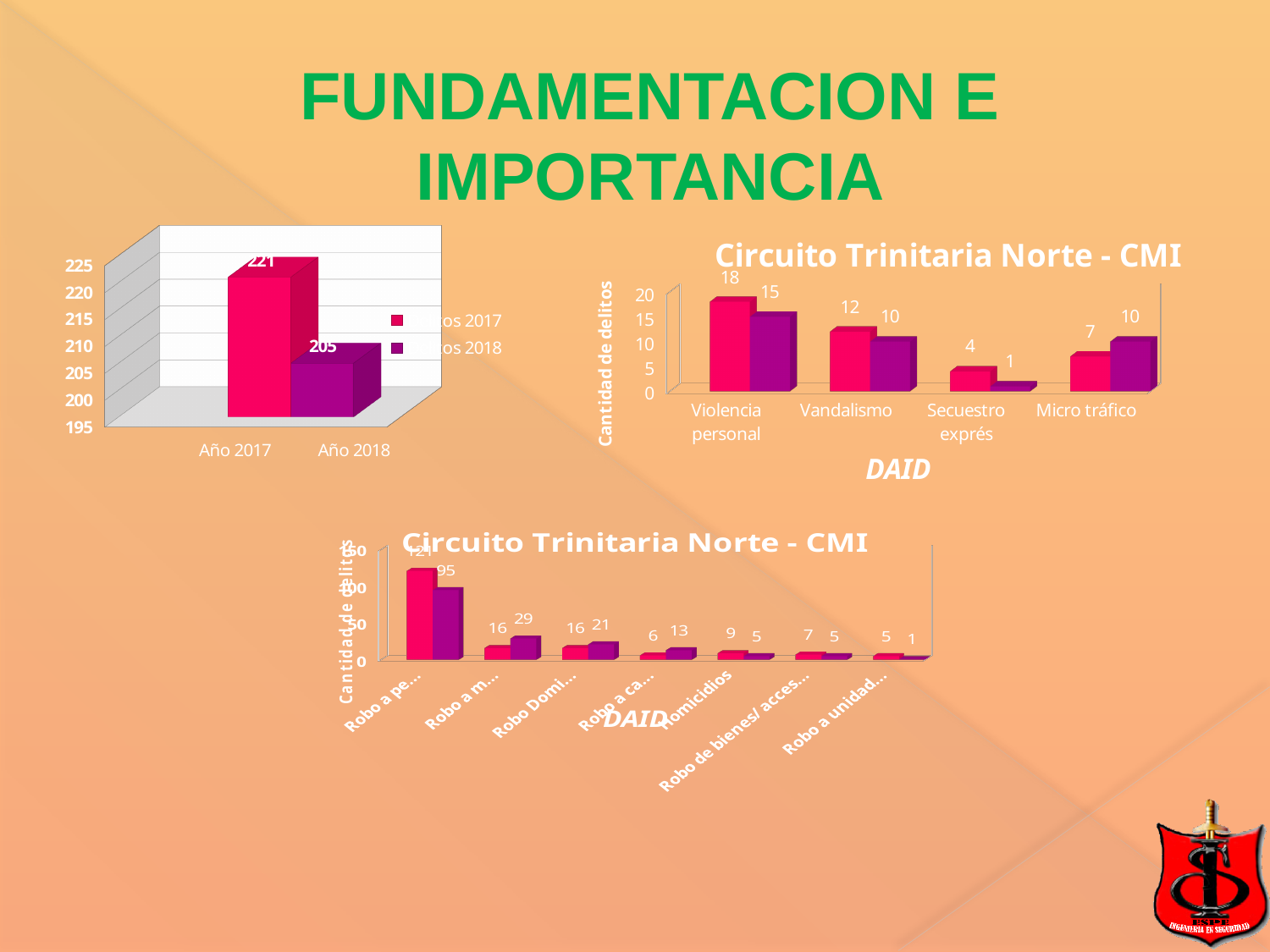
In the bottom chart, how many categories are shown on the x axis? 7 In the top-right chart, which category has the highest value? Violencia personal What kind of chart is the top-left chart? bar chart What is the y-axis title of the top-right chart? Cantidad de delitos In the top-right chart, for Micro tráfico, is the pink bar or the purple bar larger? purple In the top-right chart, what is the value of the pink bar for Violencia personal? 18 In the top-left chart, what is the value for Año 2018? 205 In the top-left chart, what is the difference between the values for Año 2017 and Año 2018? 16 In the top-right chart, how many categories are shown on the x axis? 4 In the top-left chart, what is the value for Año 2017? 221 In the top-right chart, what is the value of the purple bar for Secuestro exprés? 1 In the bottom chart, what is the value of the pink bar for Homicidios? 9